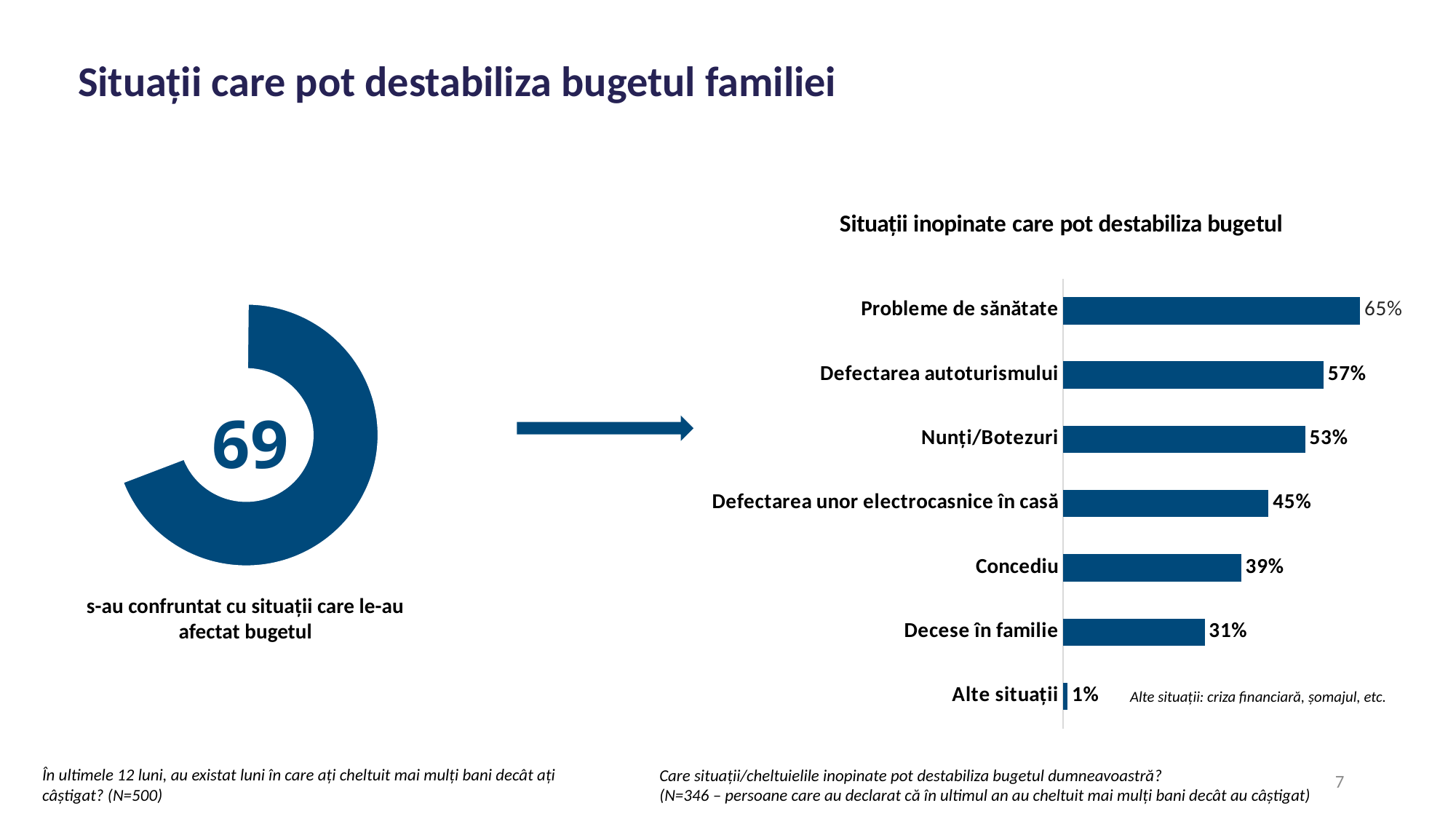
In the bar chart 'Situații inopinate care pot destabiliza bugetul', what is the value for Probleme de sănătate? 65% What number is shown in the centre of the donut chart on the left of the slide? 69 In the bar chart 'Situații inopinate care pot destabiliza bugetul', what is the difference between Defectarea autoturismului and Nunți/Botezuri? 4% In the bar chart 'Situații inopinate care pot destabiliza bugetul', what is the value for Decese în familie? 31% In the bar chart 'Situații inopinate care pot destabiliza bugetul', which is larger: Defectarea unor electrocasnice în casă or Concediu? Defectarea unor electrocasnice în casă What is the title of the bar chart on the right of the slide? Situații inopinate care pot destabiliza bugetul In the bar chart 'Situații inopinate care pot destabiliza bugetul', what is the value for Concediu? 39% What kind of chart is the chart on the left of the slide showing the number 69? Donut chart In the bar chart 'Situații inopinate care pot destabiliza bugetul', which category has the lowest value? Alte situații How many categories does the bar chart 'Situații inopinate care pot destabiliza bugetul' show? 7 What kind of chart is the chart on the right of the slide, 'Situații inopinate care pot destabiliza bugetul'? Bar chart In the bar chart 'Situații inopinate care pot destabiliza bugetul', which category has the highest value? Probleme de sănătate